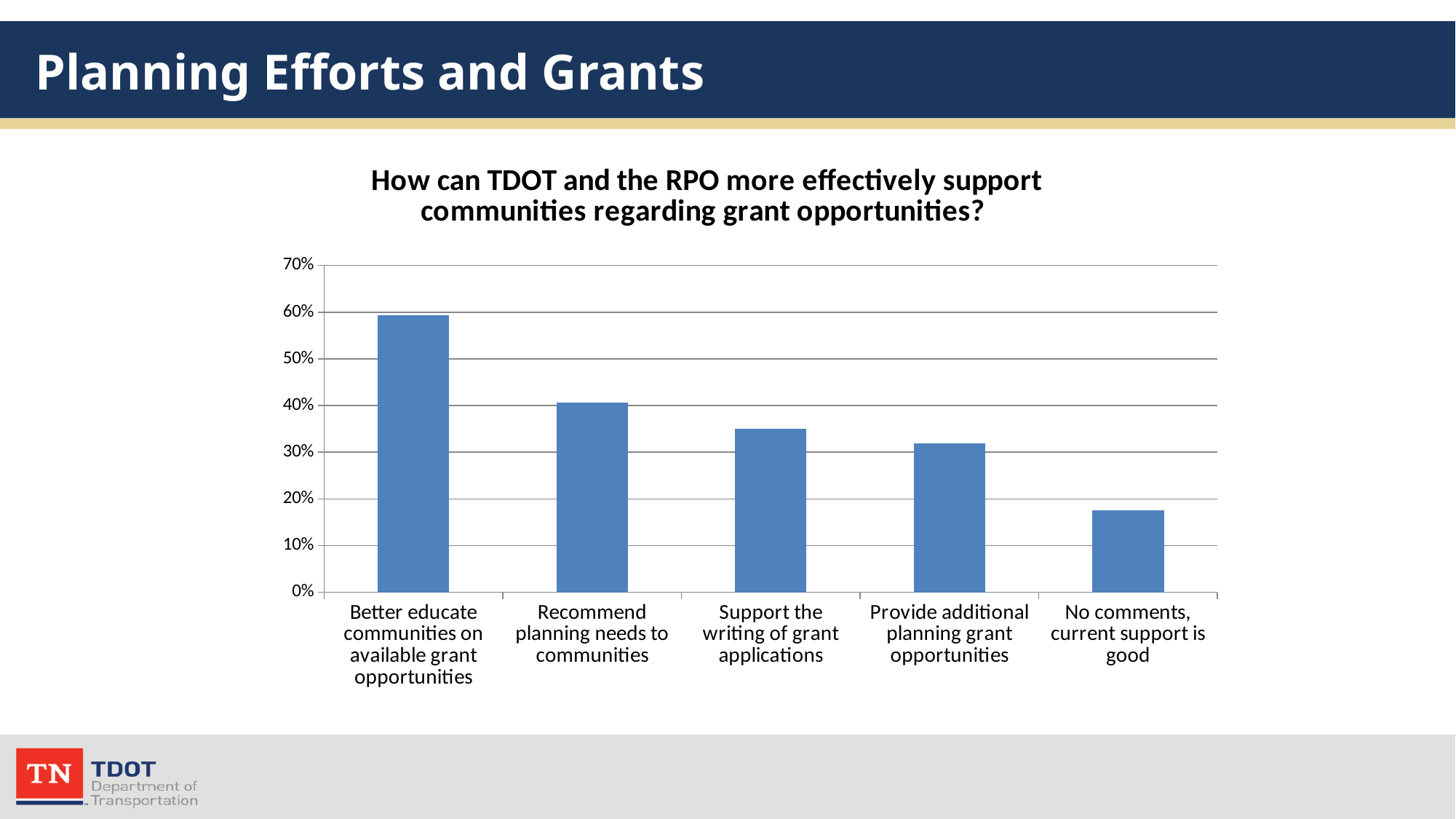
What is the title of the chart? How can TDOT and the RPO more effectively support communities regarding grant opportunities? Is the value for 'Support the writing of grant applications' greater or less than 30%? greater Which is larger: the value for 'Recommend planning needs to communities' or the value for 'Provide additional planning grant opportunities'? Recommend planning needs to communities Is the value for 'No comments, current support is good' greater or less than 20%? less What kind of chart is shown on the slide? bar chart How many categories are shown on the x axis of the chart? 5 Is the value for 'Better educate communities on available grant opportunities' greater or less than 50%? greater Which category has the highest value in the chart? Better educate communities on available grant opportunities Do the bar values rise or fall from left to right across the x axis? fall Which category has the lowest value in the chart? No comments, current support is good